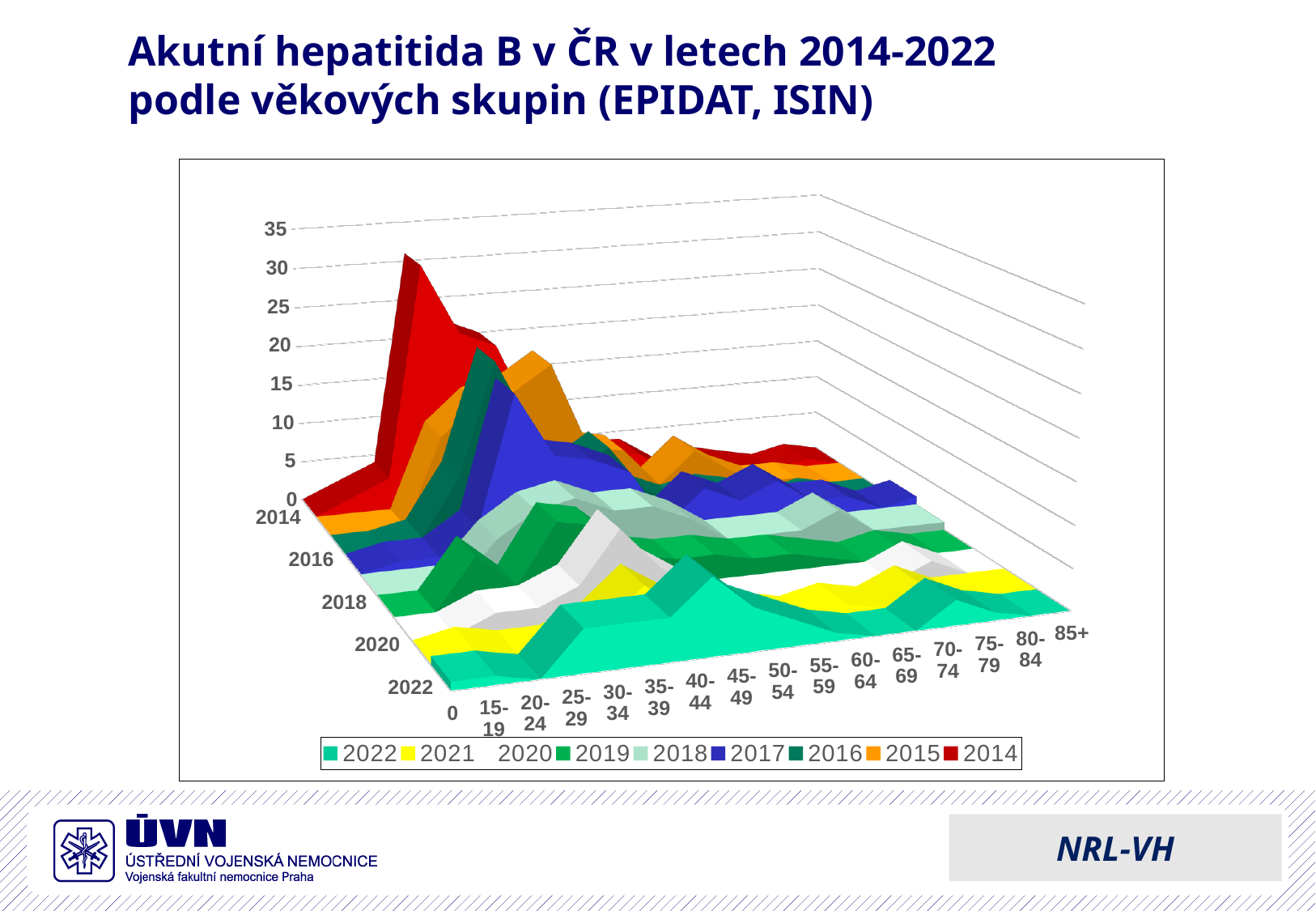
Is the highest peak of the 2014 series greater or less than 25? greater Which year is listed first in the legend? 2022 Is the value for the 2014 series at age group 0 greater or less than 5? less How many series does the legend list? 9 What is the highest value shown on the vertical axis? 35 How many age-group categories are shown along the x axis? 16 What is the title of the chart on the slide? Akutní hepatitida B v ČR v letech 2014-2022 podle věkových skupin (EPIDAT, ISIN) What kind of chart is shown on the slide? 3D area chart What is the last age-group category on the x axis? 85+ Which year's series reaches the highest peak on the chart? 2014